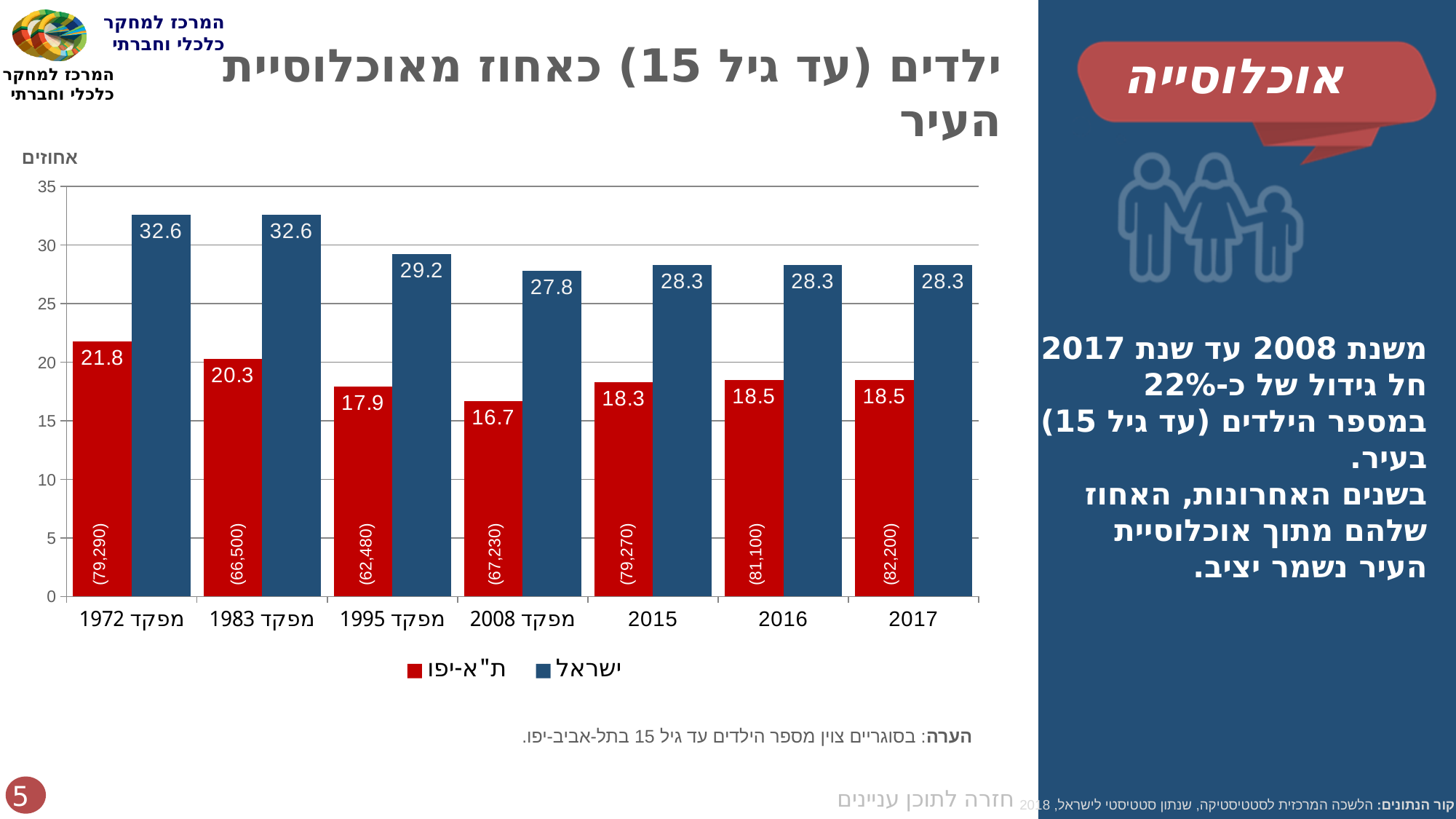
In which category is the ת"א-יפו value lowest? מפקד 2008 How many categories are shown on the x axis? 7 What is the value for ת"א-יפו in מפקד 2008? 16.7 How many series does the legend list? 2 What kind of chart is shown on the slide? Bar chart What is the value for ת"א-יפו in מפקד 1972? 21.8 What is the difference between the ישראל and ת"א-יפו values in מפקד 1995? 11.3 What is the value for ישראל in 2017? 28.3 Which is larger in 2016: the value for ישראל or for ת"א-יפו? ישראל What number of children is shown in parentheses on the ת"א-יפו bar for 2017? (82,200) In which categories is the ישראל value highest? מפקד 1972 and מפקד 1983 Which colour represents ת"א-יפו in the chart? Red